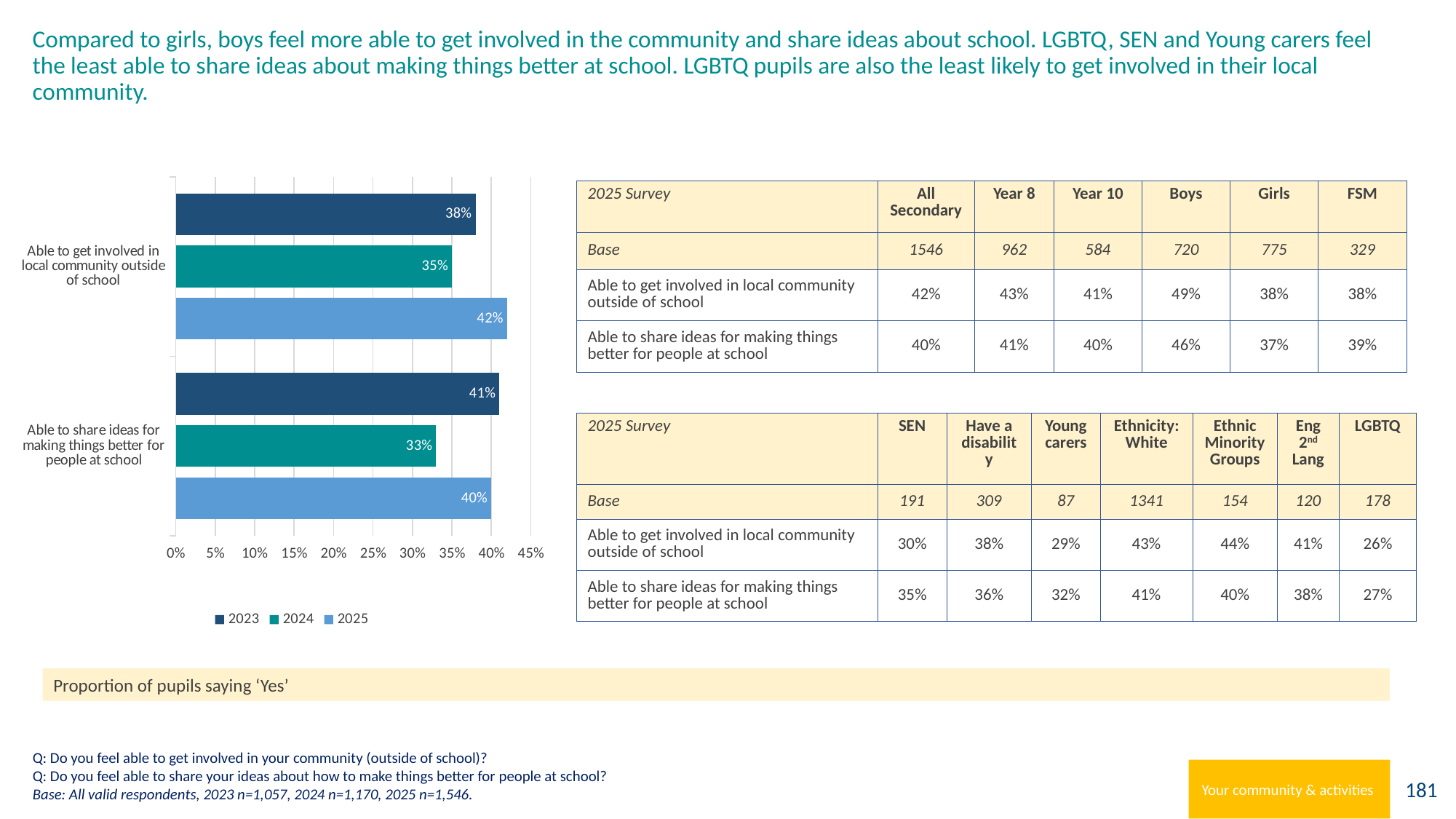
What are the legend entries of the chart? 2023, 2024, 2025 What is the 2023 value for 'Able to get involved in local community outside of school'? 38% Is the 2024 value for 'Able to share ideas for making things better for people at school' greater or less than 35%? less What is the difference between the 2025 and 2024 values for 'Able to get involved in local community outside of school'? 7% What is the 2025 value for 'Able to get involved in local community outside of school'? 42% Which year has the lowest value for 'Able to get involved in local community outside of school'? 2024 What type of chart is shown on the slide? bar chart Which is larger: the 2023 value for 'Able to share ideas for making things better for people at school' or the 2025 value for the same category? 2023 What is the 2024 value for 'Able to share ideas for making things better for people at school'? 33% How many series does the chart legend list? 3 How many categories are shown on the chart? 2 Which year has the highest value for 'Able to share ideas for making things better for people at school'? 2023